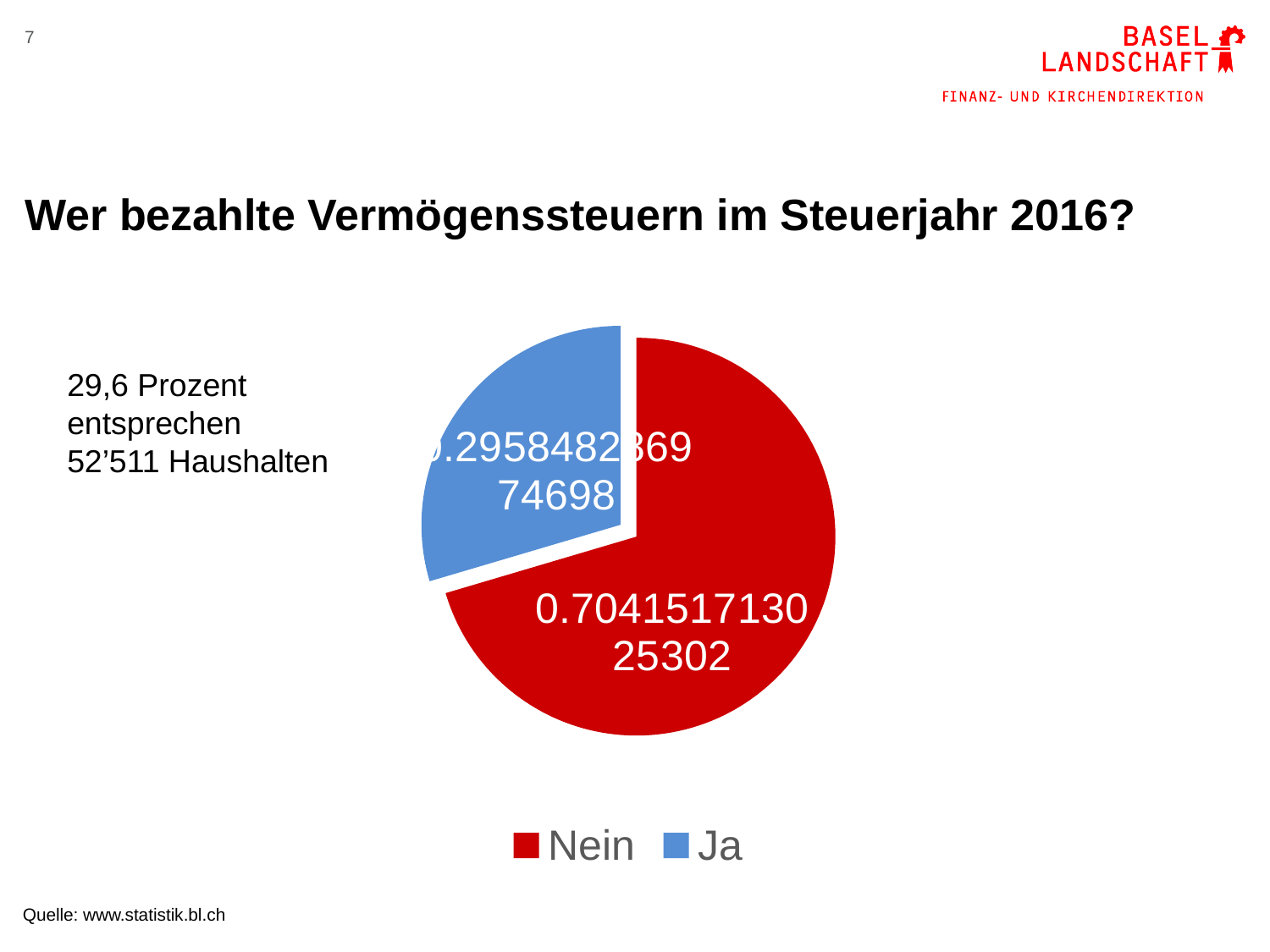
How many entries does the legend of the pie chart list? 2 How many slices does the pie chart have? 2 What value is printed on the Nein slice of the pie chart? 0.704151713025302 What is the title of the slide above the pie chart? Wer bezahlte Vermögenssteuern im Steuerjahr 2016? Which slice of the pie chart is the largest? Nein Which slice of the pie chart is the smallest? Ja Which slice is larger in the pie chart, Nein or Ja? Nein What colour is the Ja slice in the pie chart? blue What kind of chart is shown on the slide? pie chart